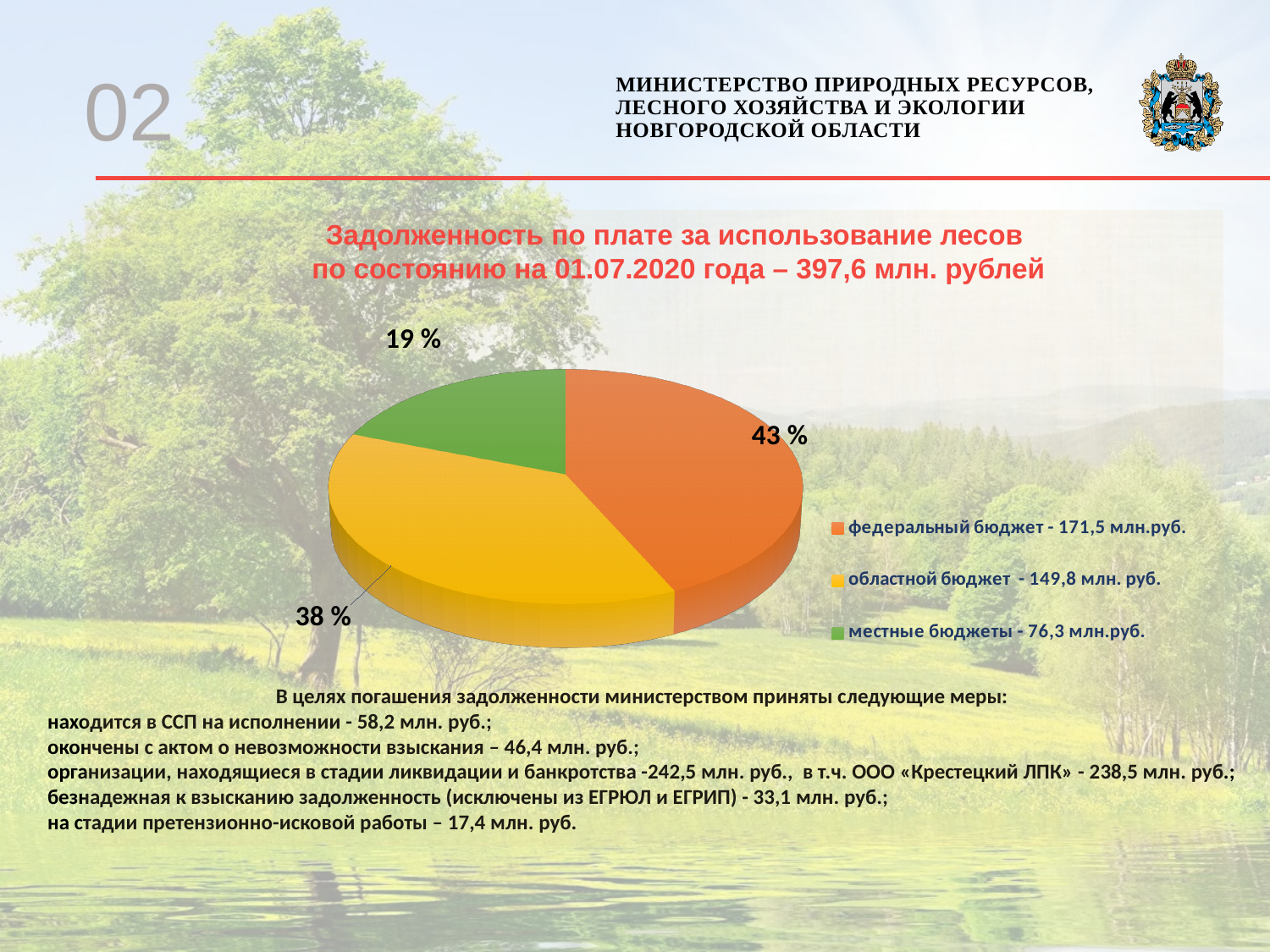
What percentage of the pie is labelled for the yellow slice (областной бюджет)? 38 % According to the legend, what is the amount of debt for местные бюджеты? 76,3 млн.руб. What total debt amount is stated in the chart title as of 01.07.2020? 397,6 млн. рублей What percentage of the pie is labelled for the green slice (местные бюджеты)? 19 % How many slices does the pie chart have? 3 According to the legend, what is the amount of debt for областной бюджет? 149,8 млн. руб. What is the difference in млн. руб. between the федеральный бюджет and областной бюджет debt amounts? 21,7 млн. руб. What percentage of the pie is labelled for the orange slice (федеральный бюджет)? 43 % Which budget category has the largest share of the pie? федеральный бюджет Which budget category has the smallest share of the pie? местные бюджеты According to the legend, what is the amount of debt for федеральный бюджет? 171,5 млн.руб. What kind of chart is shown on the slide? pie chart